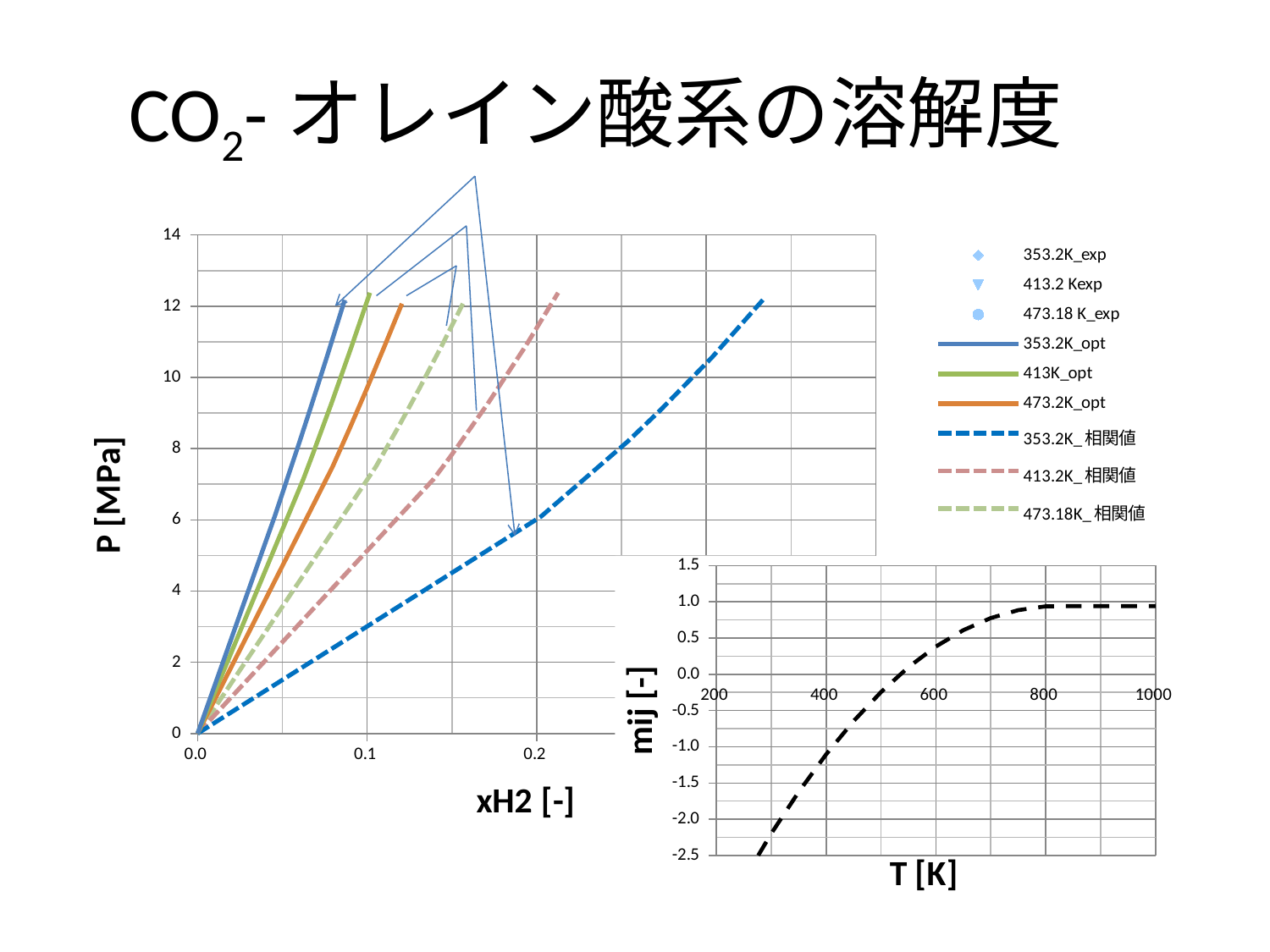
In the small inset chart (mij vs T), is the value of mij at T = 400 K greater or less than 0? less In the small inset chart (mij vs T), does mij rise or fall as T increases from 200 K to 600 K? rise In the large P vs xH2 chart, what is the label of the y axis? P [MPa] In the large P vs xH2 chart, do the plotted lines rise or fall as xH2 increases? rise How many series does the legend of the large P vs xH2 chart list? 9 How many charts are shown on the slide? 2 What kind of chart is the large chart on the left (P vs xH2)? line chart In the large P vs xH2 chart, is the value of the 353.2K_相関値 line at xH2 = 0.1 greater or less than 4 MPa? less In the small inset chart (mij vs T), is the value of mij at T = 800 K greater or less than 0.5? greater In the large P vs xH2 chart, what is the label of the x axis? xH2 [-] In the large P vs xH2 chart, at xH2 = 0.1, which line is higher: 413K_opt or 353.2K_相関値? 413K_opt In the large P vs xH2 chart, which series extends to the largest xH2 value? 353.2K_相関値